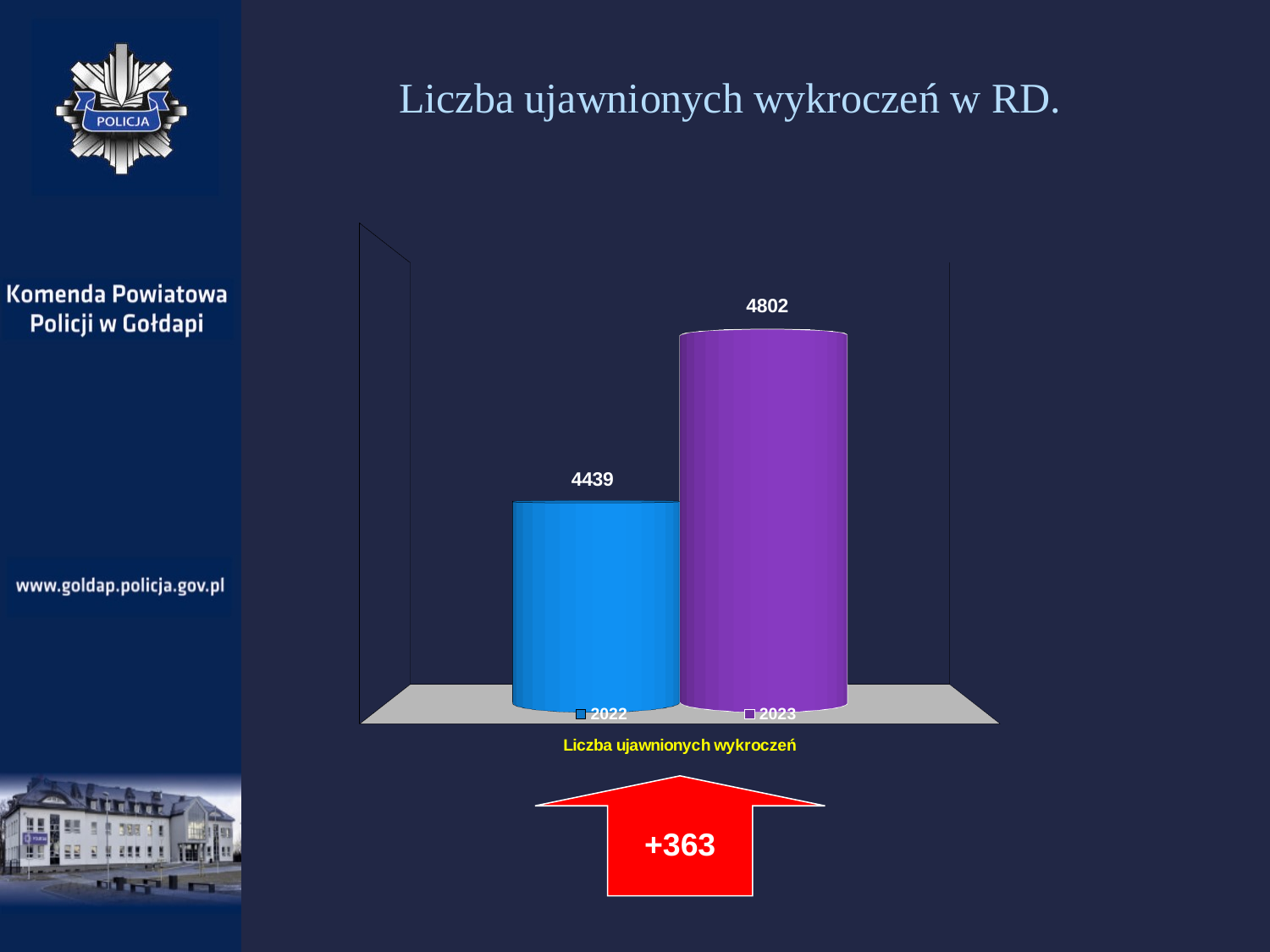
Which year has the lower value? 2022 How many series does the legend list? 2 Do the values rise or fall from 2022 to 2023? Rise What is the category label shown below the chart? Liczba ujawnionych wykroczeń What colour is the bar for 2023? Purple What is the title of the slide? Liczba ujawnionych wykroczeń w RD. What is the difference between the 2023 and 2022 values? 363 Is the value for 2023 larger than the value for 2022? Yes What is the value for 2023? 4802 What kind of chart is shown? Bar chart Which year has the higher value? 2023 What is the value for 2022? 4439